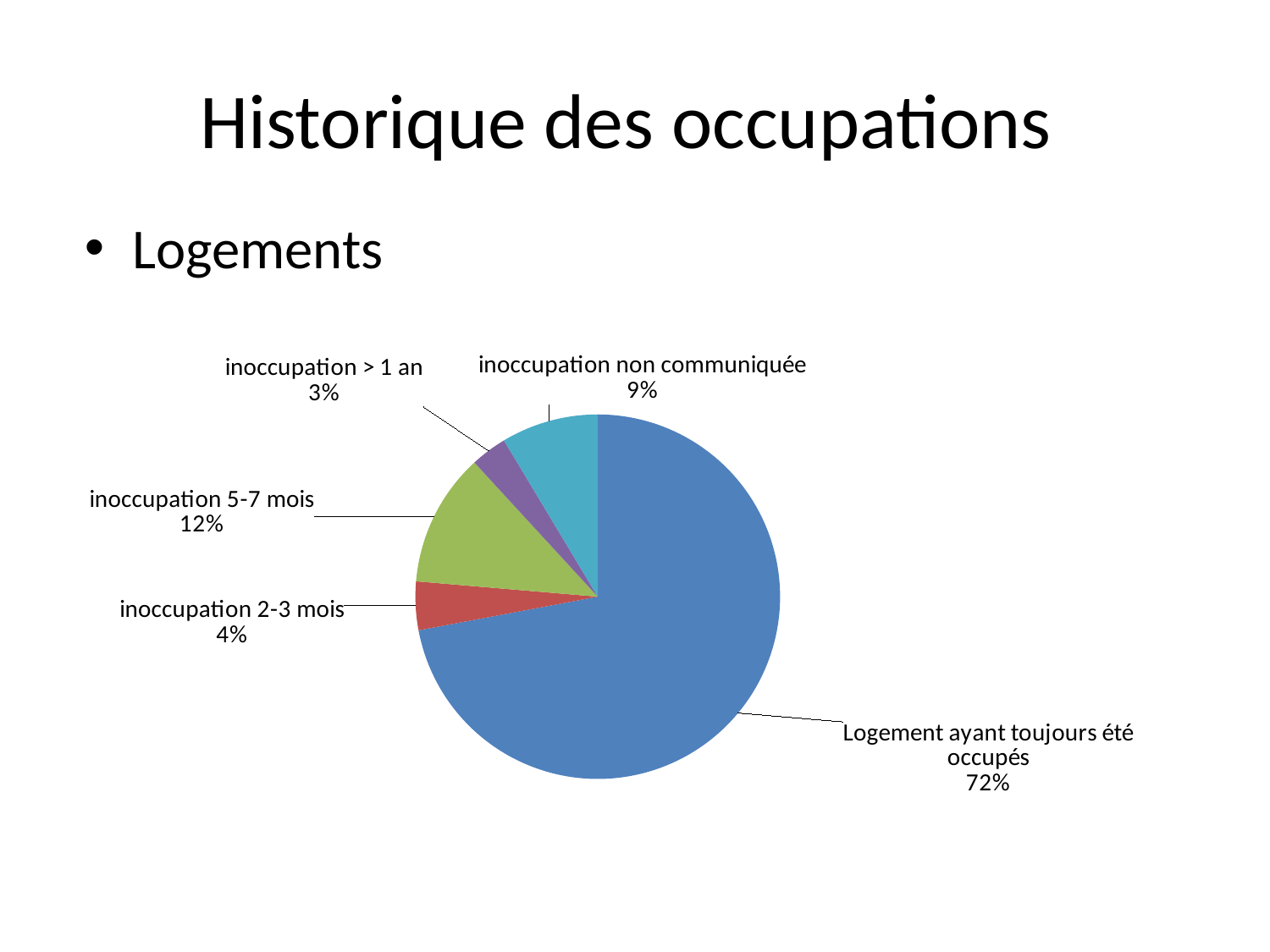
What share of the pie is 'inoccupation 5-7 mois'? 12% What is the title of the slide containing the pie chart? Historique des occupations Which category has the largest slice of the pie? Logement ayant toujours été occupés What share of the pie is 'inoccupation non communiquée'? 9% How many slices does the pie chart have? 5 Which is larger: 'inoccupation non communiquée' or 'inoccupation 5-7 mois'? inoccupation 5-7 mois Which category has the smallest slice of the pie? inoccupation > 1 an What share of the pie is 'Logement ayant toujours été occupés'? 72% What is the difference in percentage points between 'inoccupation 5-7 mois' and 'inoccupation 2-3 mois'? 8 What kind of chart is shown on the slide? pie chart